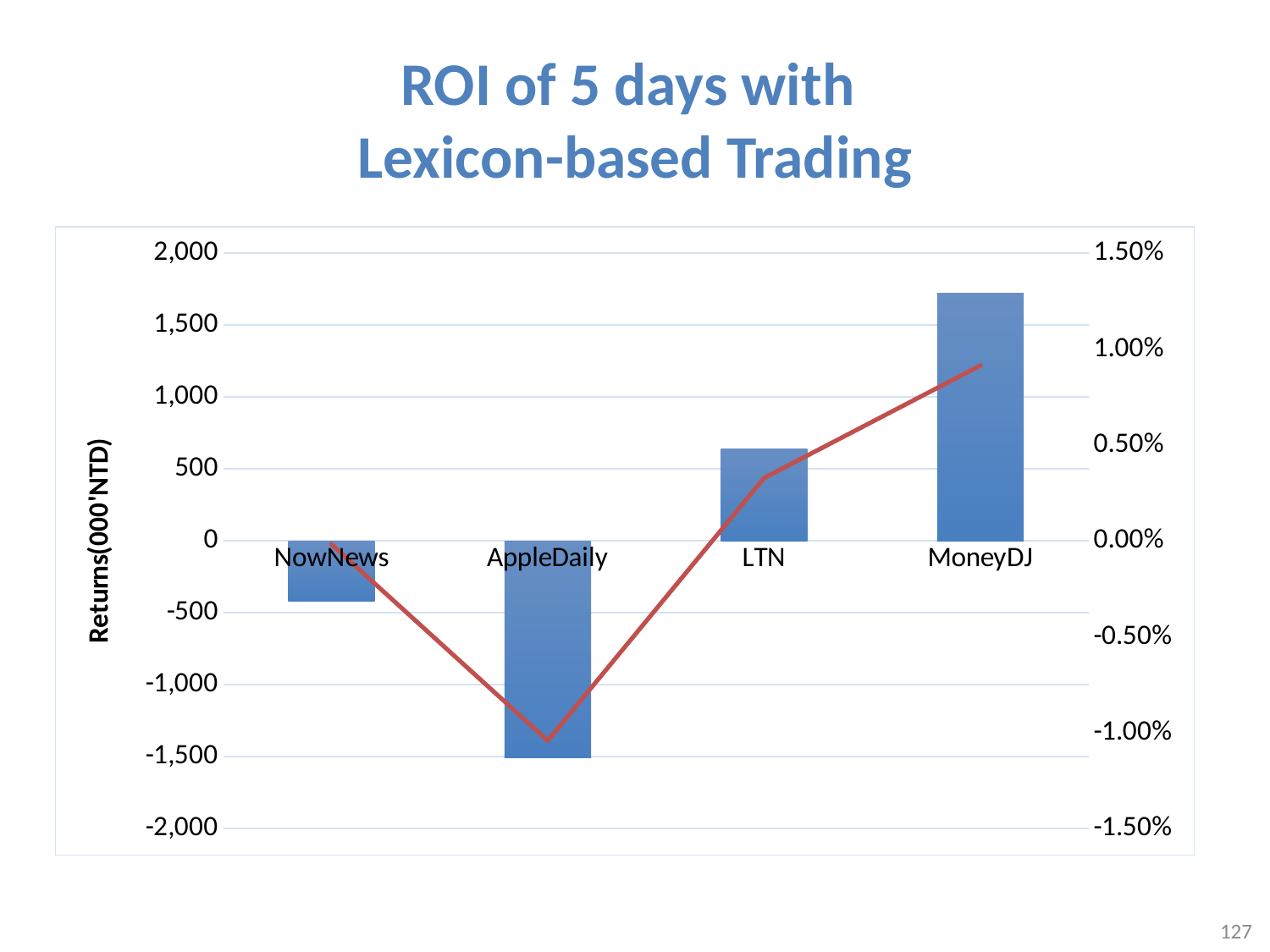
Which category has the lowest bar for returns? AppleDaily Which has a larger returns bar, MoneyDJ or LTN? MoneyDJ Does the red line rise or fall from AppleDaily to MoneyDJ? rise Which has a larger returns bar, LTN or NowNews? LTN How many categories are shown on the x axis? 4 Is the returns bar for LTN greater or less than 500? greater Is the returns bar for MoneyDJ greater or less than 1,500? greater Is the returns bar for NowNews greater or less than 0? less Which category has the highest bar for returns? MoneyDJ What kind of chart is this? Combined bar and line chart What is the label of the left vertical axis? Returns(000'NTD)